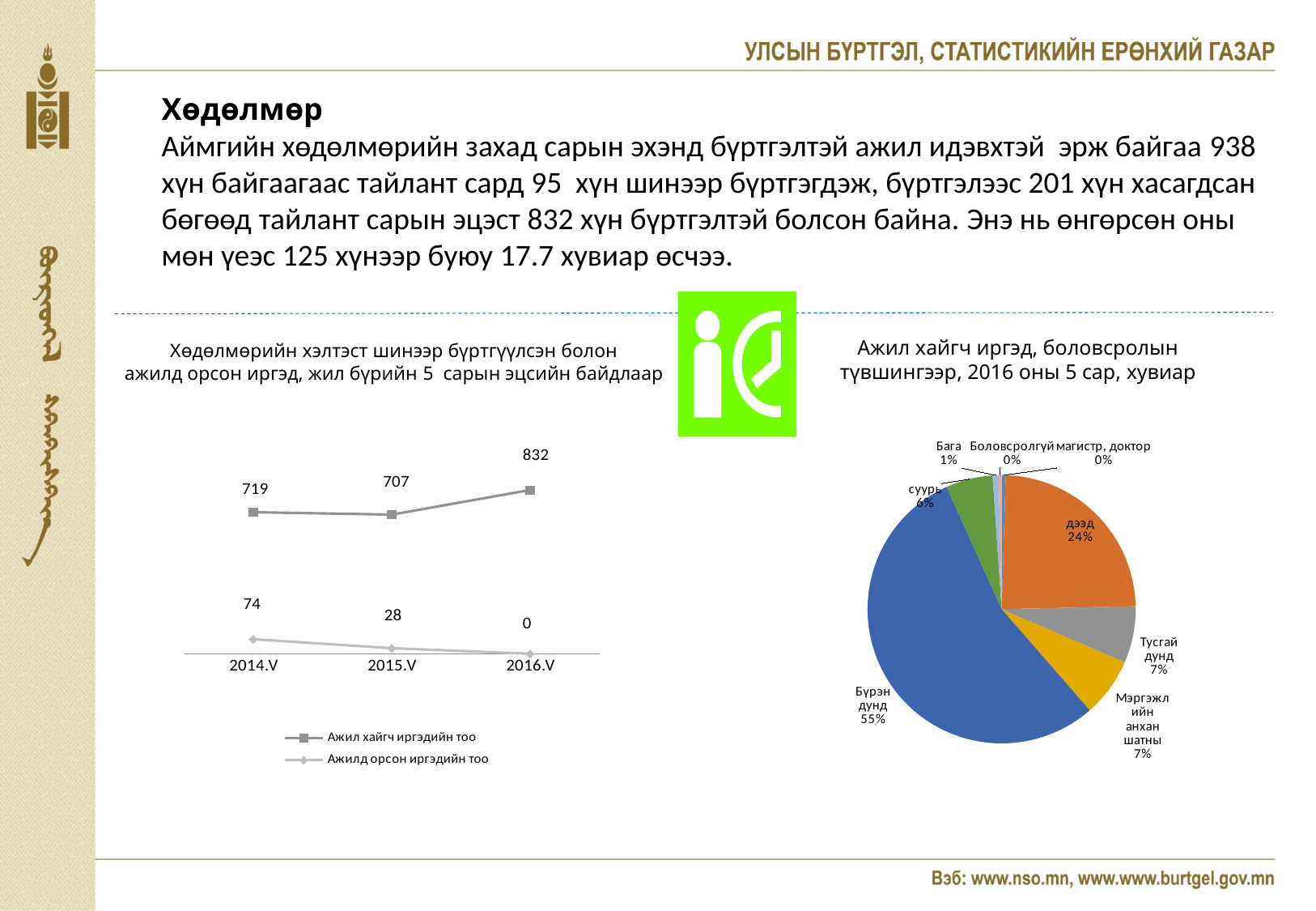
On the left chart, in which period is Ажилд орсон иргэдийн тоо lowest? 2016.V On the right pie chart, which is larger, дээд or суурь? дээд On the left chart, what is the value of Ажил хайгч иргэдийн тоо for 2016.V? 832 On the left chart, what is the difference between Ажил хайгч иргэдийн тоо in 2016.V and 2015.V? 125 On the right pie chart, which category has the largest share? Бүрэн дунд On the right pie chart, what share does Бүрэн дунд have? 55% On the left chart, in which period is Ажил хайгч иргэдийн тоо highest? 2016.V On the left chart, does Ажилд орсон иргэдийн тоо rise or fall from 2014.V to 2016.V? Fall On the left chart, how many series does the legend list? 2 On the left chart, what is the value of Ажилд орсон иргэдийн тоо for 2014.V? 74 On the left chart, how many periods are shown on the x axis? 3 What kind of chart is the left chart? Line chart